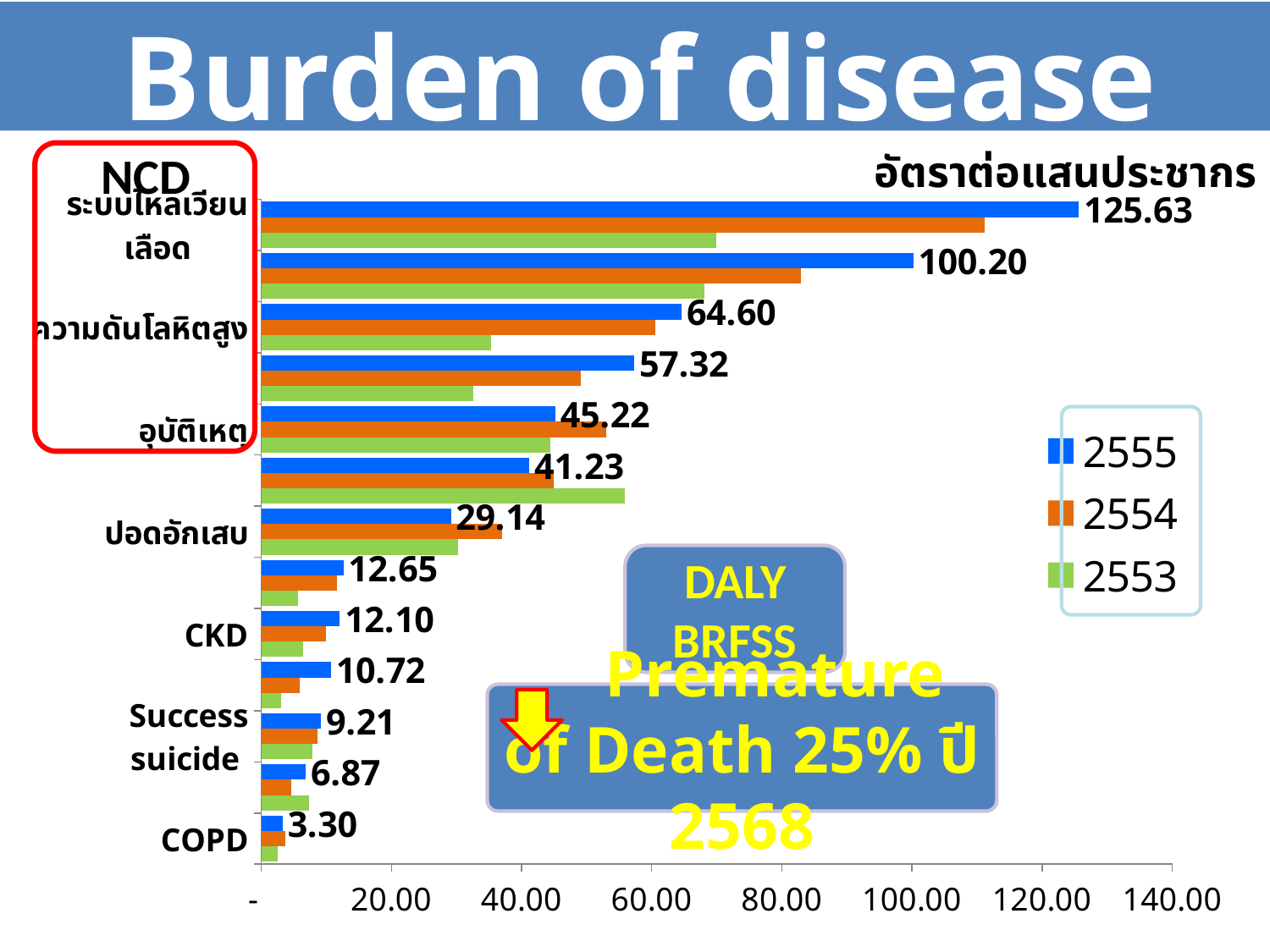
What is the 2555 value for COPD? 3.30 What is the 2555 value for ความดันโลหิตสูง? 64.60 Which labelled category has the lowest 2555 value? COPD What is the 2555 value for CKD? 12.10 Which labelled category has the highest 2555 value? ระบบไหลเวียนเลือด What is the 2555 value for อุบัติเหตุ? 45.22 How many series does the legend list? 3 What is the difference between the 2555 values for ระบบไหลเวียนเลือด and ความดันโลหิตสูง? 61.03 What are the three series listed in the legend? 2555, 2554, 2553 What is the 2555 value for ระบบไหลเวียนเลือด? 125.63 Is the 2554 value for ระบบไหลเวียนเลือด greater or less than 100.00? greater What kind of chart is shown on the slide? bar chart